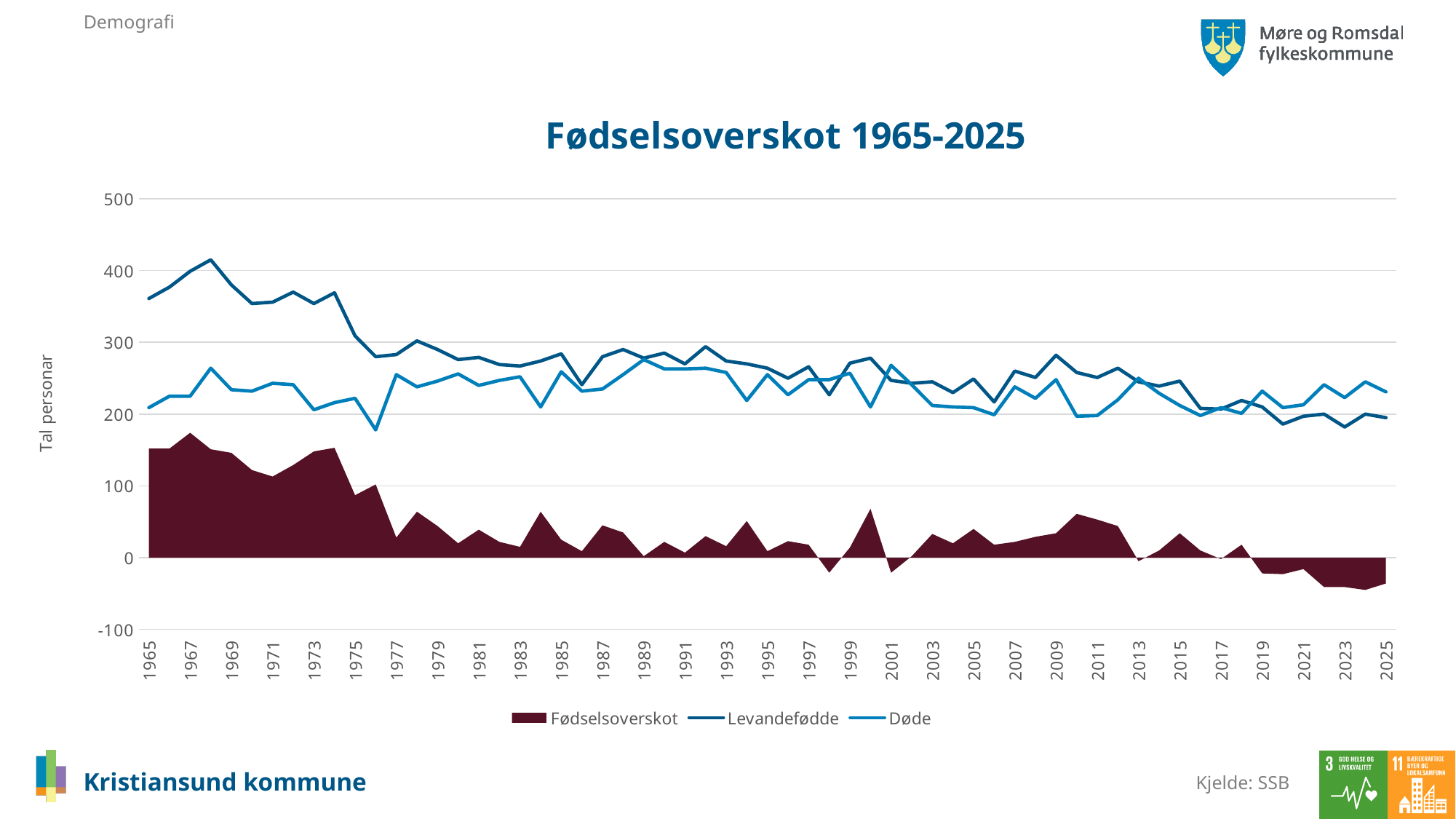
Is the value for Levandefødde in 2025 greater or less than 300? less How many series does the legend list? 3 In 1965, which is larger: Levandefødde or Døde? Levandefødde Does the Fødselsoverskot series generally rise or fall from 1965 to 2025? fall Is the value for Levandefødde in 1965 greater or less than 300? greater Is the value for Fødselsoverskot in 1965 greater or less than 100? greater Which series are listed in the legend? Fødselsoverskot, Levandefødde, Døde What is the title of the chart? Fødselsoverskot 1965-2025 In which year does the Døde series reach its lowest value? 1976 In which year does the Levandefødde series reach its highest value? 1968